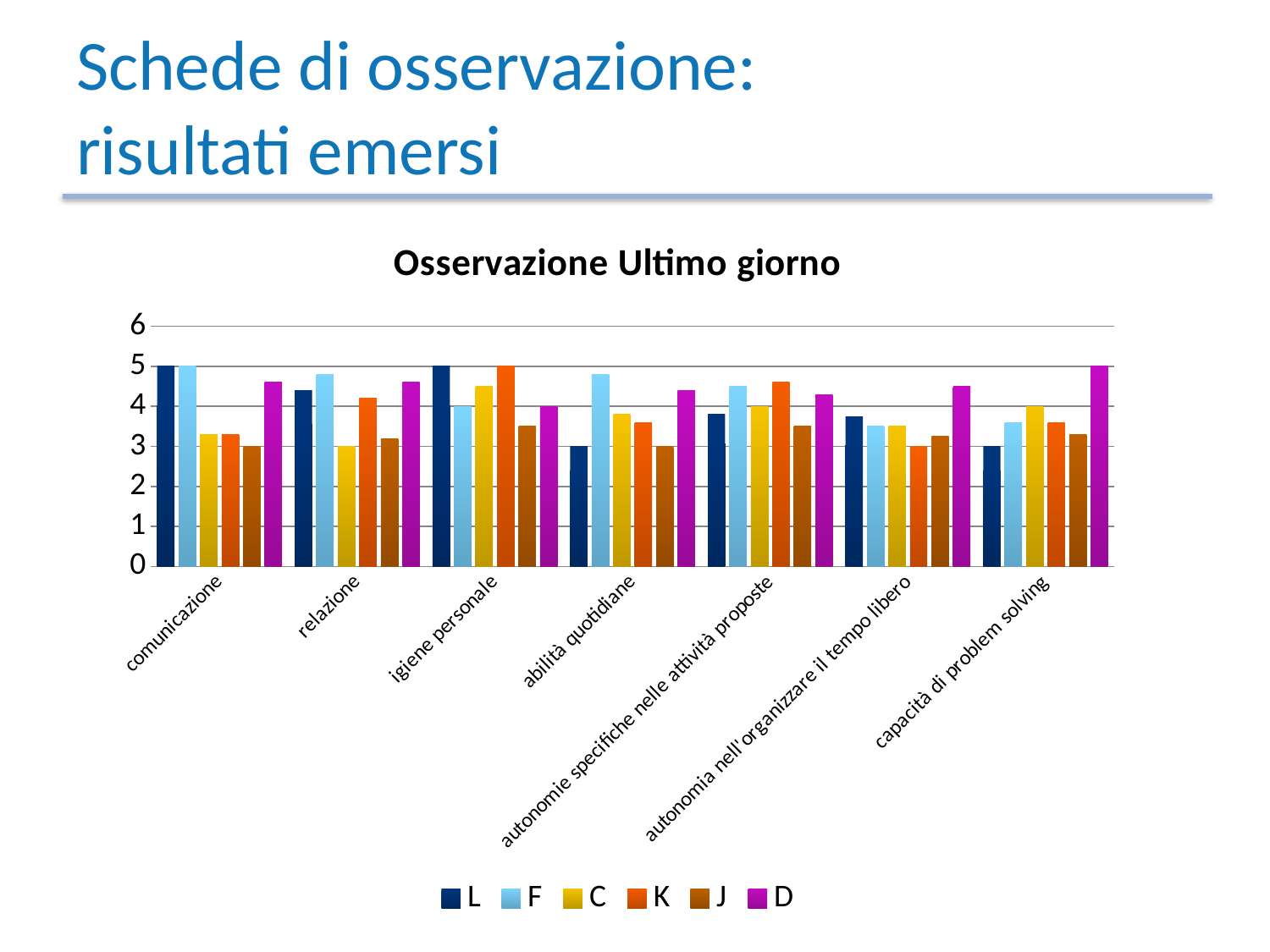
What is the value for series D in the capacità di problem solving category? 5 Which series has the highest value in the capacità di problem solving category? D Which series has the highest value in the autonomia nell'organizzare il tempo libero category? D What is the value for series K in the igiene personale category? 5 What is the difference between series L and series J in the comunicazione category? 2 Is the value for series D in the comunicazione category greater or less than 4? greater What is the value for series L in the abilità quotidiane category? 3 How many categories are shown on the x axis? 7 How many series does the legend list? 6 What is the value for series L in the comunicazione category? 5 Is the value for series F in the relazione category greater or less than 4? greater Which is larger in the relazione category, series L or series F? F